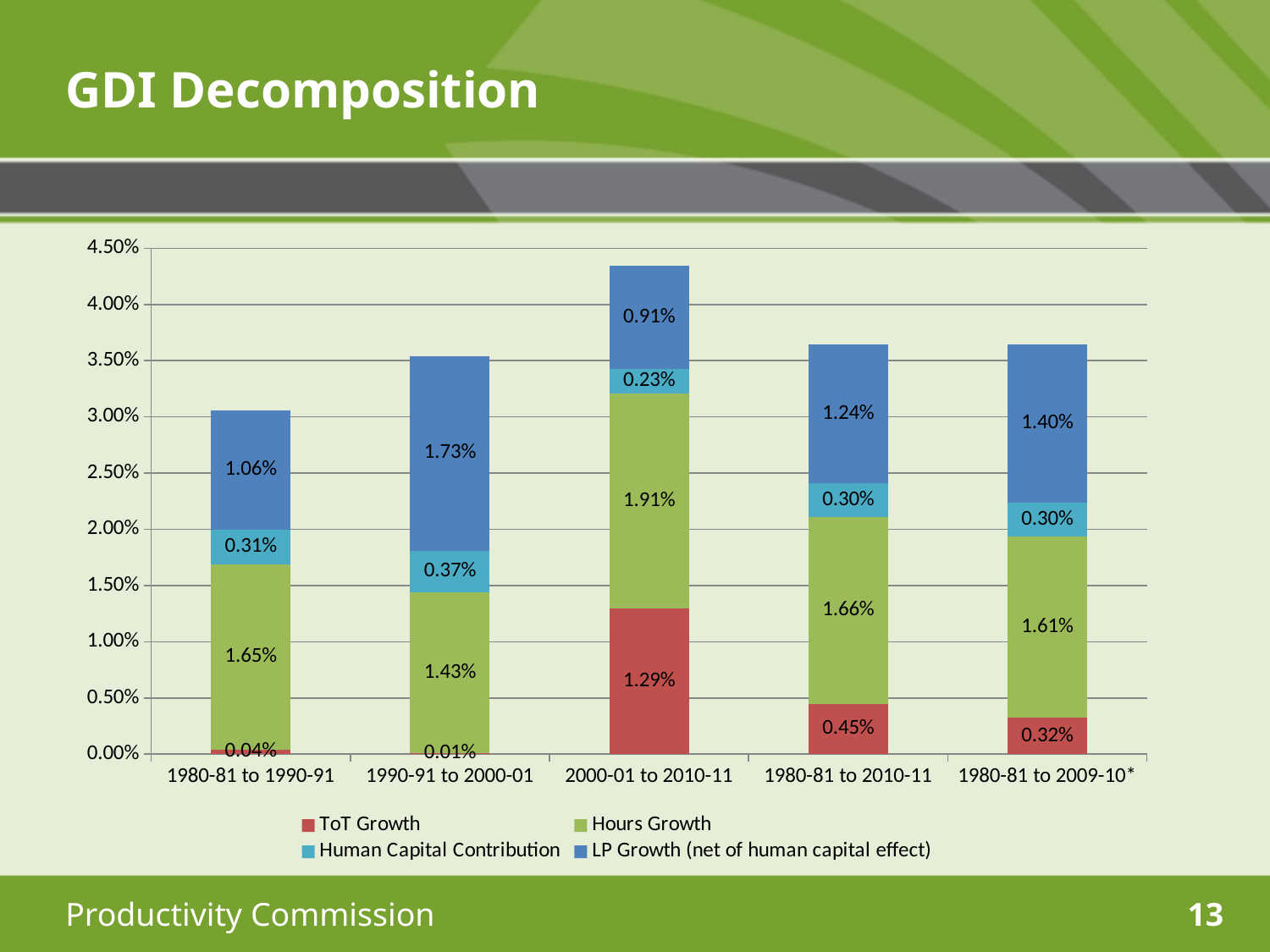
How many series does the legend list? 4 What is the LP Growth (net of human capital effect) value for 1990-91 to 2000-01? 1.73% What kind of chart is shown on the slide? Stacked bar chart Which is larger: the Hours Growth value for 1980-81 to 2010-11 or for 1980-81 to 2009-10*? 1980-81 to 2010-11 What is the ToT Growth value for 1980-81 to 2010-11? 0.45% Which period has the highest ToT Growth value? 2000-01 to 2010-11 Which period has the lowest Human Capital Contribution value? 2000-01 to 2010-11 What is the title of the slide? GDI Decomposition How many periods (categories) are shown on the x axis? 5 What is the difference between the LP Growth (net of human capital effect) values for 1990-91 to 2000-01 and 1980-81 to 1990-91? 0.67% What is the Hours Growth value for 2000-01 to 2010-11? 1.91% What is the total of the stacked bar for 1980-81 to 1990-91? 3.06%